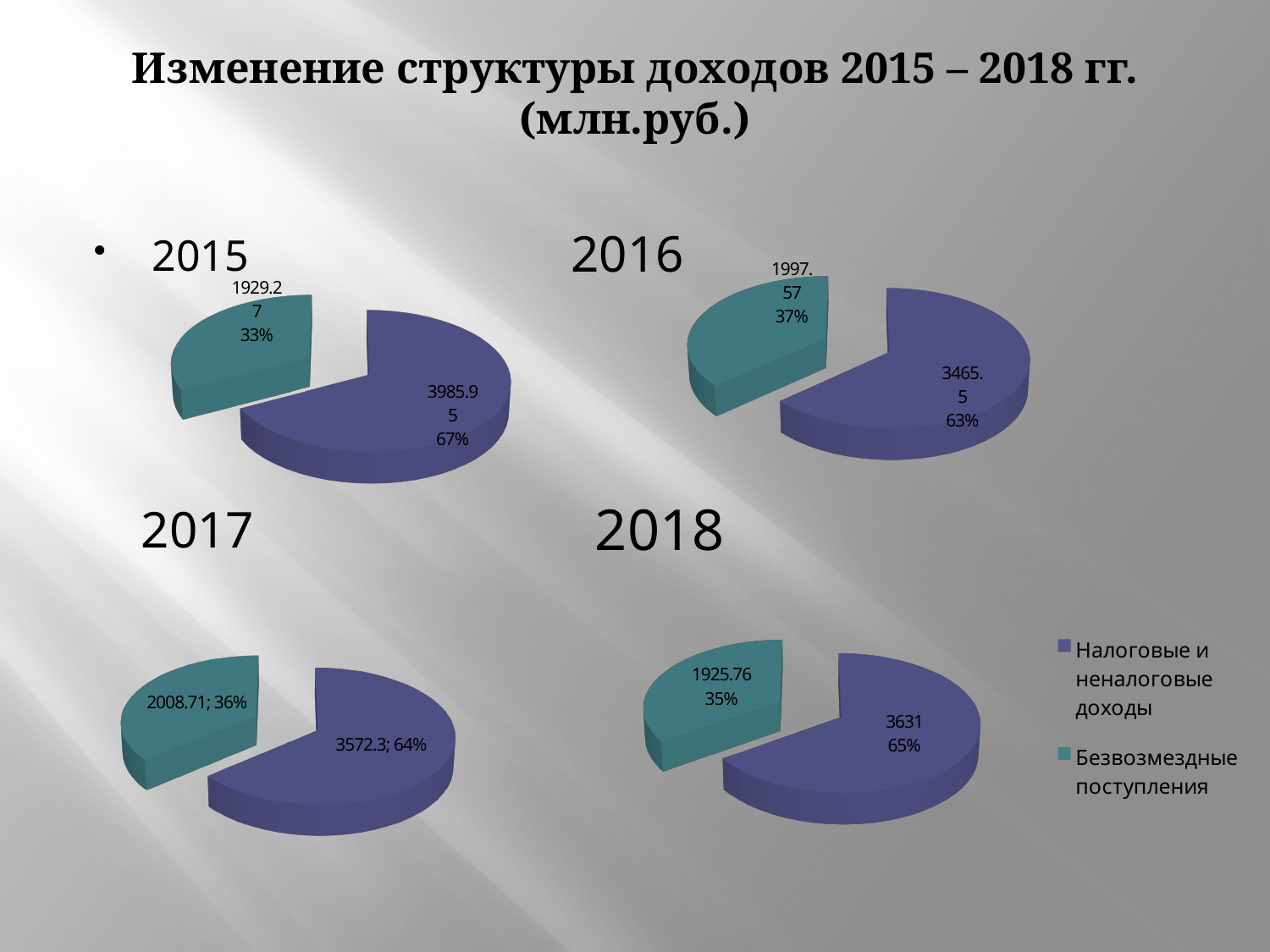
In the 2017 pie chart, what share do Налоговые и неналоговые доходы have? 64% In the 2017 pie chart, what is the value for Безвозмездные поступления? 2008.71 In the 2015 pie chart, what is the value for Безвозмездные поступления? 1929.27 What type of charts are shown on the slide? Pie charts In the 2016 pie chart, what share do Безвозмездные поступления have? 37% How many pie charts are on the slide? 4 In the 2015 pie chart, what share do Налоговые и неналоговые доходы have? 67% Which colour represents Безвозмездные поступления in the legend? Teal In the 2018 pie chart, which category is the largest? Налоговые и неналоговые доходы How many series does the legend list? 2 In the 2016 pie chart, what is the value for Налоговые и неналоговые доходы? 3465.5 In the 2018 pie chart, what is the value for Налоговые и неналоговые доходы? 3631